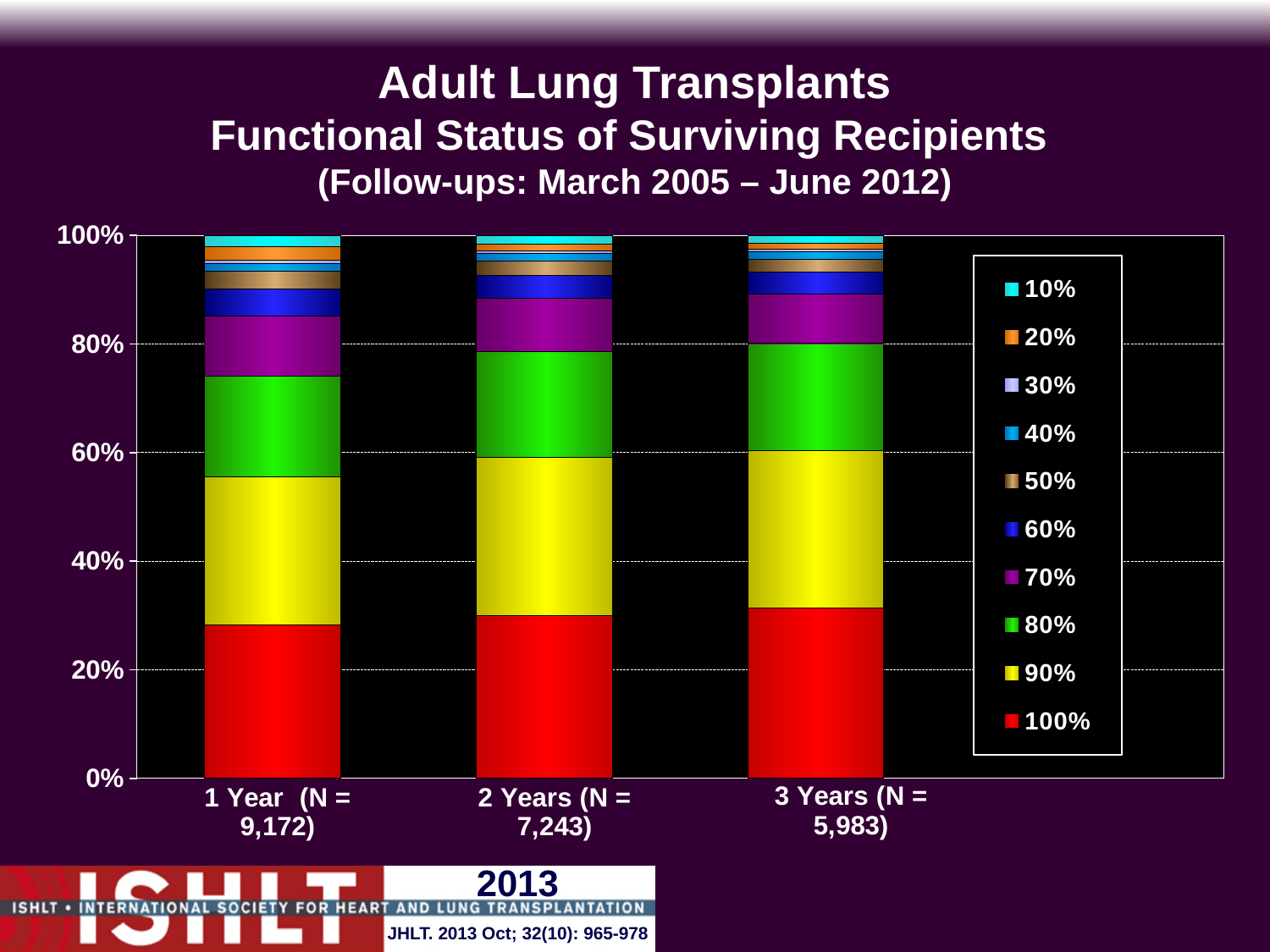
What follow-up period is given in the chart title? March 2005 – June 2012 Which colour represents the 90% functional status series in the legend? yellow Is the share of the 100% functional status segment (red) in the 1 Year bar greater or less than 20%? greater Does the red (100%) segment rise or fall from 1 Year to 3 Years? rise Which category has the largest N value? 1 Year (N = 9,172) How many series does the legend list? 10 Is the share of the 100% functional status segment (red) in the 1 Year bar greater or less than 40%? less What kind of chart is shown on the slide? stacked bar chart Is the share of the 100% functional status segment (red) in the 3 Years bar greater or less than 40%? less What is the N value shown for the 1 Year category? 9,172 What is the N value shown for the 3 Years category? 5,983 How many categories (follow-up time points) are shown on the x axis? 3